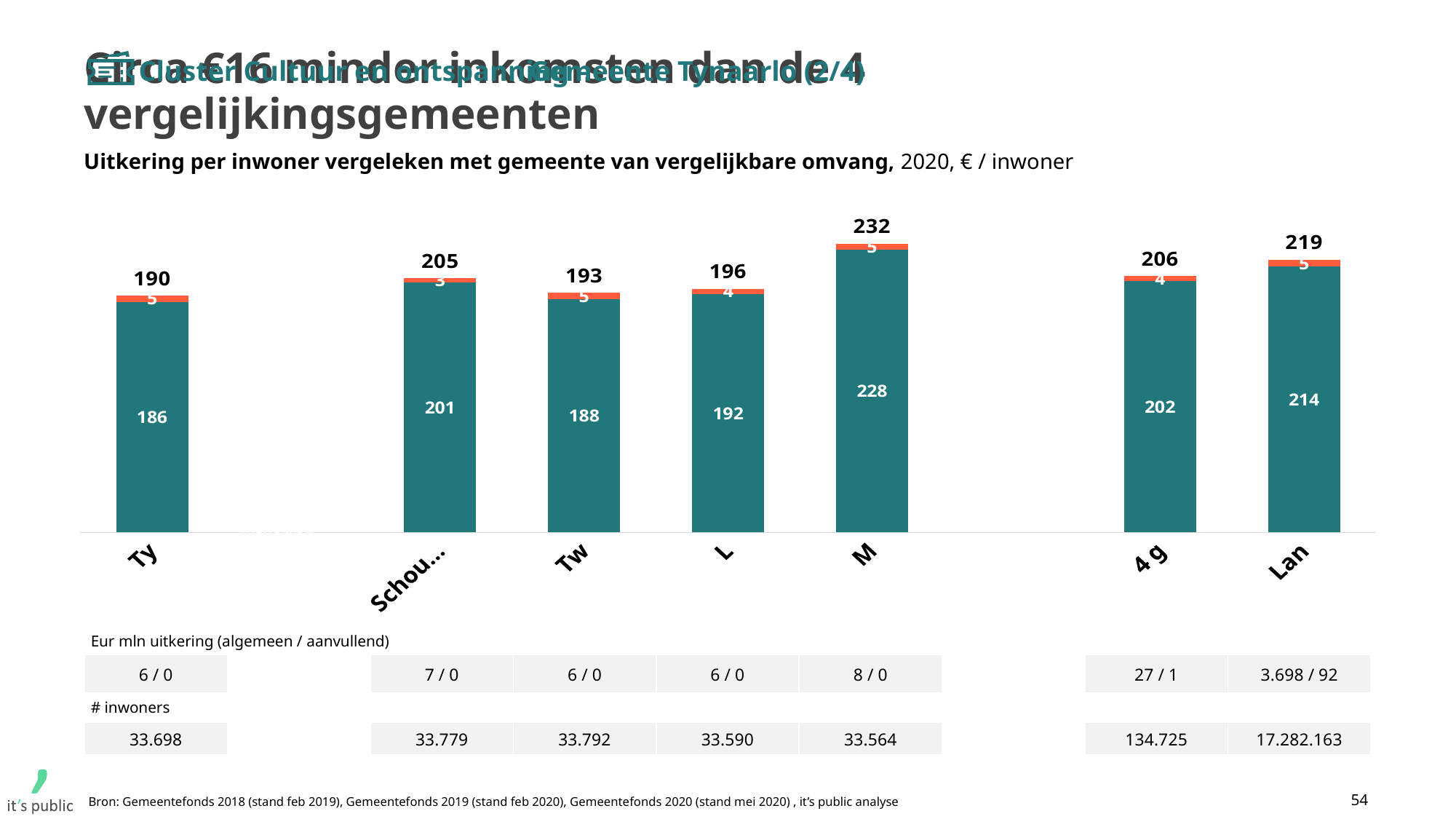
What is the total value shown above the bar for Ty? 190 What is the difference between the total for M and the total for Ty? 42 Which category has the lowest total value in the chart? Ty What is the total value shown above the bar for M? 232 How many bars (categories) are plotted in the chart? 7 Which category has the highest total value in the chart? M What kind of chart is shown on the slide? stacked bar chart What is the value of the large teal segment of the bar for Lan? 214 Which has a larger total value, Lan or 4 g? Lan What is the total value shown above the bar for Tw? 193 What unit is stated in the chart subtitle for the values plotted? € / inwoner What is the value of the small orange segment on top of the bar for L? 4